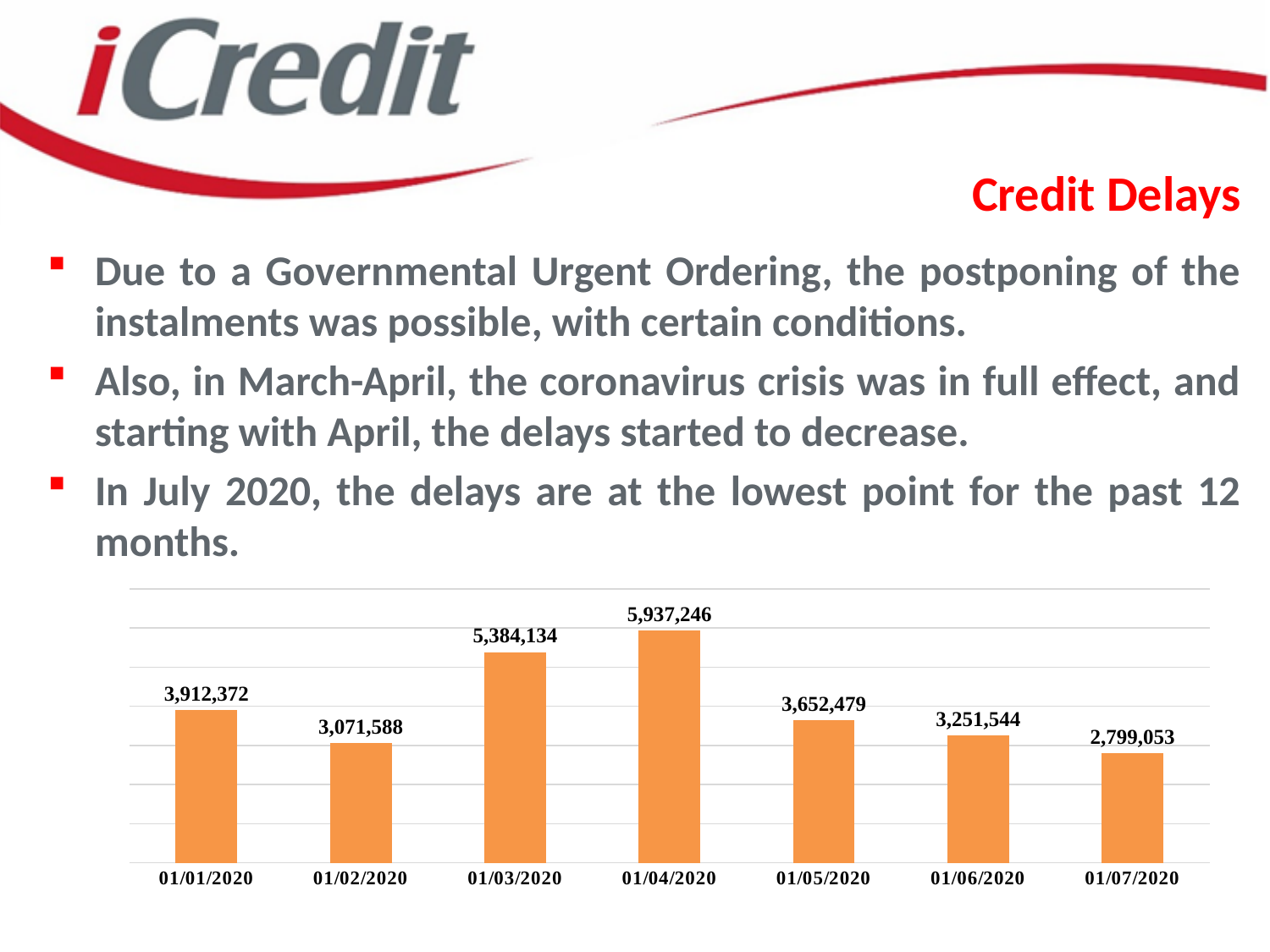
What is the value for 01/02/2020? 3,071,588 What kind of chart is shown on the slide? bar chart Which date has the highest value? 01/04/2020 What is the difference between the values for 01/01/2020 and 01/07/2020? 1,113,319 Which is larger, the value for 01/05/2020 or the value for 01/06/2020? 01/05/2020 What is the difference between the values for 01/04/2020 and 01/03/2020? 553,112 Do the values rise or fall from 01/04/2020 to 01/07/2020? fall Which is larger, the value for 01/01/2020 or the value for 01/02/2020? 01/01/2020 Which date has the lowest value? 01/07/2020 What is the value for 01/07/2020? 2,799,053 What is the value for 01/04/2020? 5,937,246 How many dates are shown on the x axis? 7